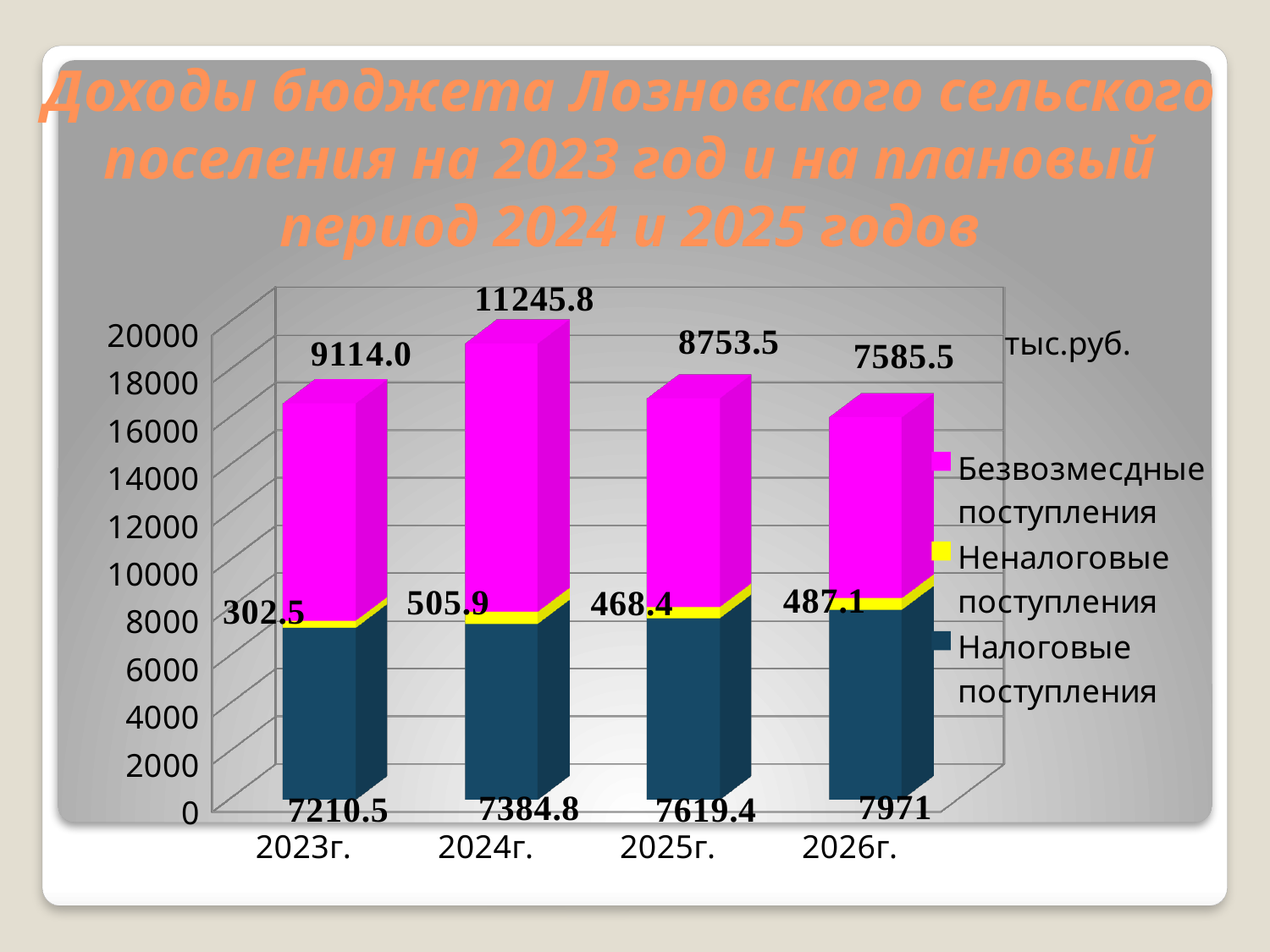
In which year is Безвозмездные поступления the highest? 2024г. How many year categories are shown on the x axis? 4 How many series does the legend list? 3 What is the value of Безвозмездные поступления for 2025г.? 8753.5 What is the value of Неналоговые поступления for 2023г.? 302.5 What is the value of Налоговые поступления for 2024г.? 7384.8 What is the difference between Налоговые поступления in 2026г. and in 2023г.? 760.5 Do the values of Налоговые поступления rise or fall from 2023г. to 2026г.? Rise Which is larger: Безвозмездные поступления in 2023г. or in 2026г.? 2023г. What type of chart is shown on the slide? Stacked bar chart In which year is Неналоговые поступления the lowest? 2023г. What is the total of the stacked bar for 2024г.? 19136.5